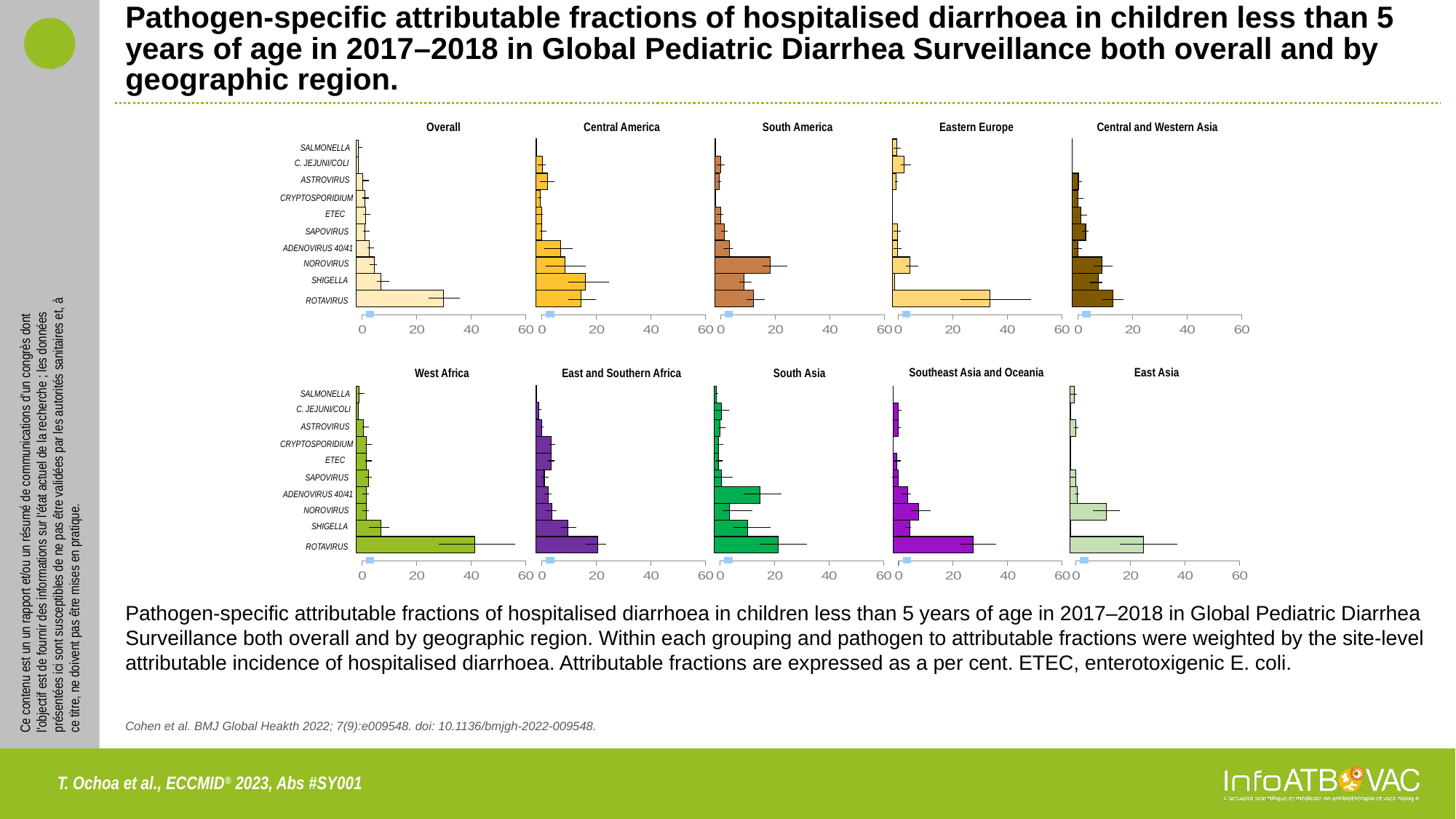
How many separate chart panels are shown on the slide? 10 In the East Asia panel, which is larger, the value for Rotavirus or the value for Norovirus? Rotavirus How many pathogen categories are listed on the y axis of the Overall panel? 10 In the South America panel, which pathogen has the highest attributable fraction? Norovirus What kind of chart is used in each of the regional panels on the slide? Bar chart In the South Asia panel, is the value for Rotavirus greater or less than 40? less In the Eastern Europe panel, is the value for Rotavirus greater or less than 20? greater In the Overall panel, which pathogen has the highest attributable fraction? Rotavirus In the Central and Western Asia panel, is the value for Rotavirus greater or less than 20? less In the West Africa panel, which pathogen has the highest attributable fraction? Rotavirus What is the title of the top-left chart panel? Overall